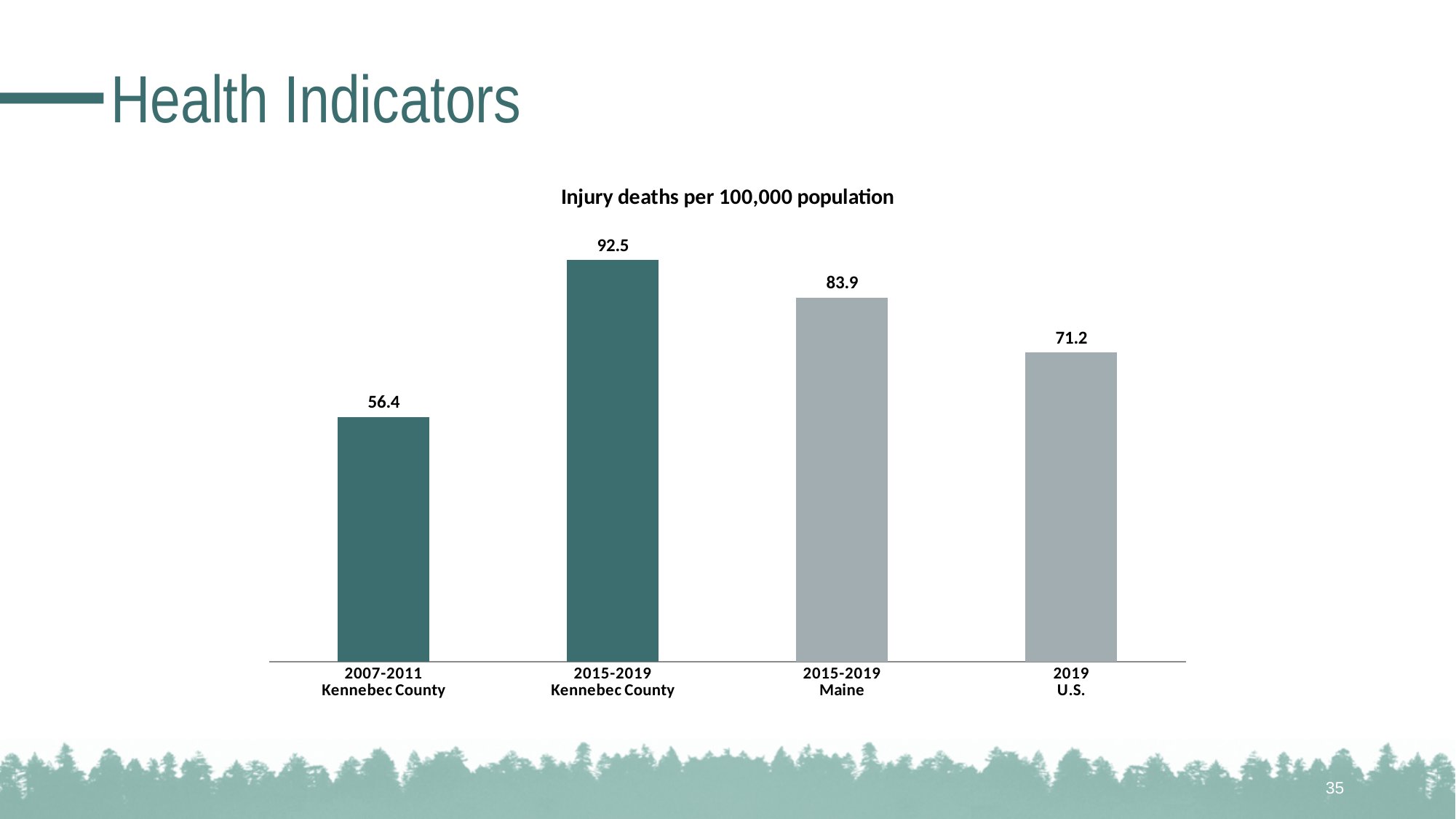
Which is larger, the value for 2015-2019 Kennebec County or the value for 2015-2019 Maine? 2015-2019 Kennebec County What is the value for 2015-2019 Maine? 83.9 How many bars are shown in the chart? 4 What is the value for 2019 U.S.? 71.2 Which category has the lowest value? 2007-2011 Kennebec County What is the value for 2007-2011 Kennebec County? 56.4 What is the difference between the 2015-2019 Maine value and the 2019 U.S. value? 12.7 What is the title of the chart? Injury deaths per 100,000 population What kind of chart is shown on the slide? Bar chart What is the value for 2015-2019 Kennebec County? 92.5 What is the difference between the 2015-2019 Kennebec County value and the 2007-2011 Kennebec County value? 36.1 Which category has the highest value? 2015-2019 Kennebec County